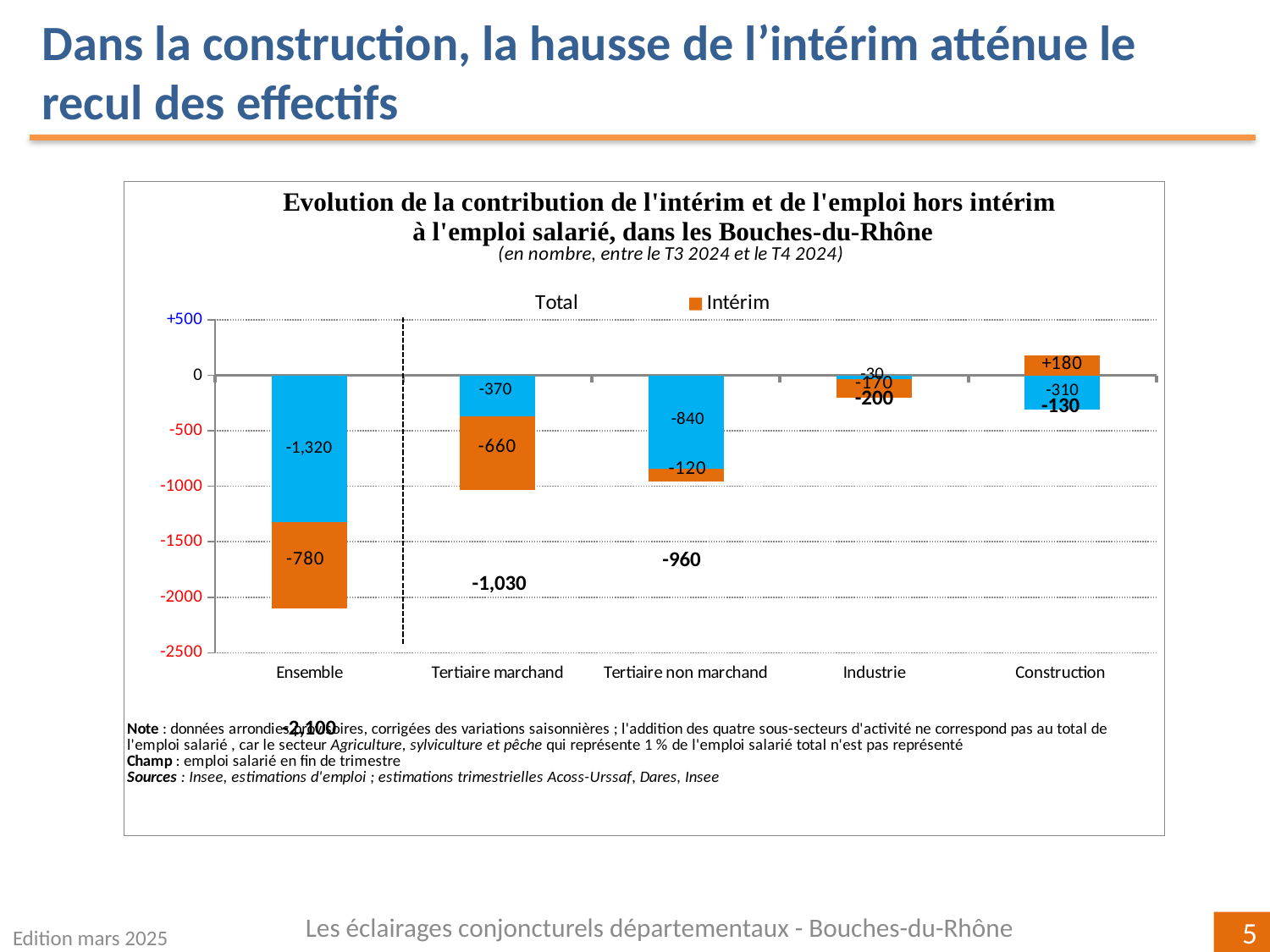
What is the total value shown for Tertiaire marchand? -1,030 What is the total value shown for Industrie? -200 What is the difference between the Intérim values for Tertiaire marchand (-660) and Tertiaire non marchand (-120)? 540 Which is more negative: the Intérim value for Industrie or the Intérim value for Tertiaire non marchand? Industrie What is the Intérim value for Tertiaire marchand? -660 What kind of chart is this? Stacked bar chart Which category has the only positive Intérim value? Construction How many categories are shown on the x axis? 5 What is the Intérim value for Construction? +180 What is the Intérim value for Ensemble? -780 Which category has the lowest (most negative) Intérim value? Ensemble What is the blue (non-Intérim) value for Tertiaire non marchand? -840